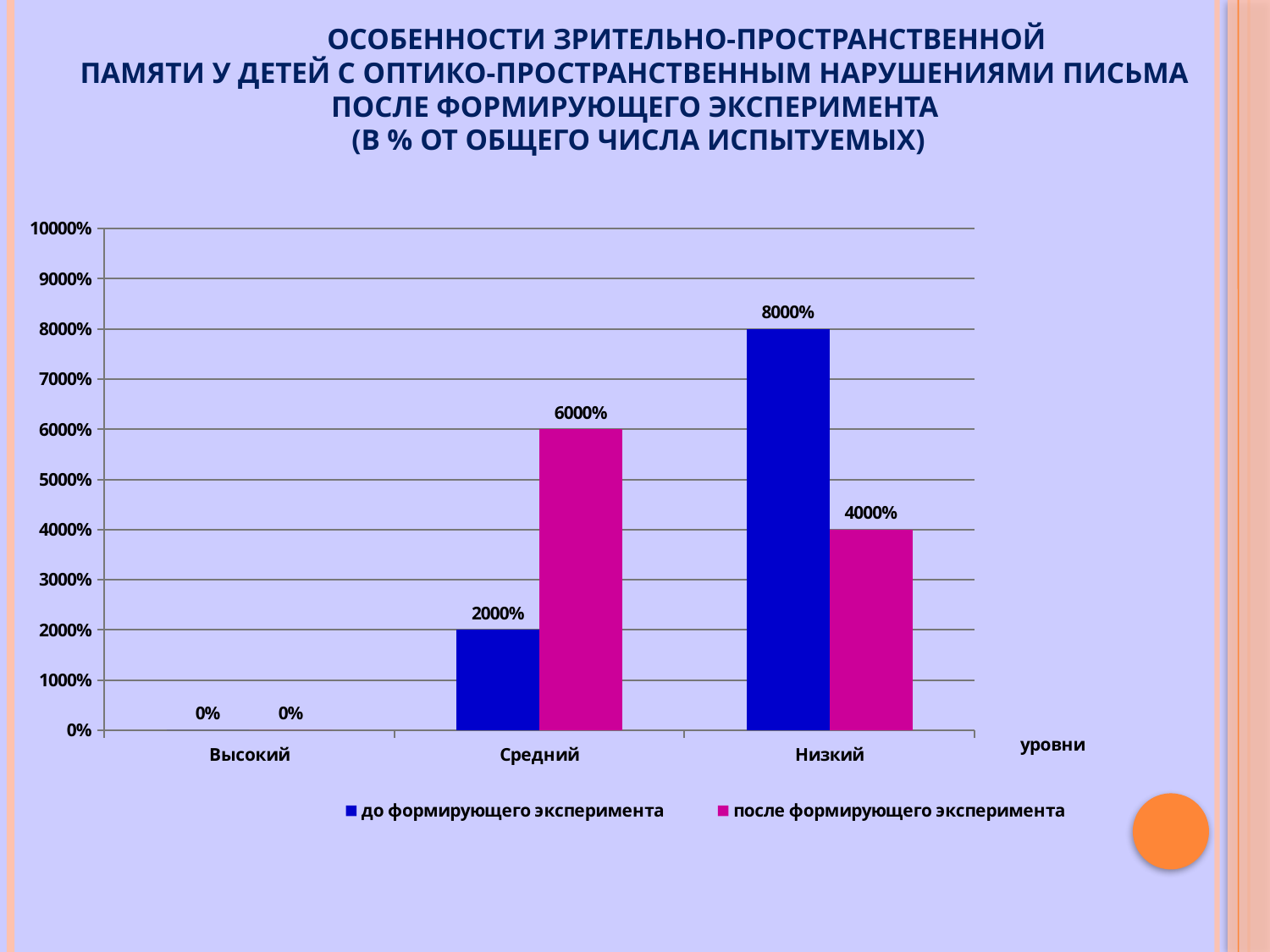
What is the value for Низкий in the series 'после формирующего эксперимента'? 4000% What kind of chart is shown on the slide? bar chart What is the value for Средний in the series 'до формирующего эксперимента'? 2000% What is the value for Высокий in the series 'до формирующего эксперимента'? 0% For Средний, which series has the larger value: 'до формирующего эксперимента' or 'после формирующего эксперимента'? после формирующего эксперимента What is the value for Низкий in the series 'до формирующего эксперимента'? 8000% What is the difference between the 'до формирующего эксперимента' and 'после формирующего эксперимента' values for Низкий? 4000% What is the value for Средний in the series 'после формирующего эксперимента'? 6000% How many categories are shown on the x axis? 3 How many series does the legend list? 2 Which category has the highest value in the series 'после формирующего эксперимента'? Средний Which category has the highest value in the series 'до формирующего эксперимента'? Низкий